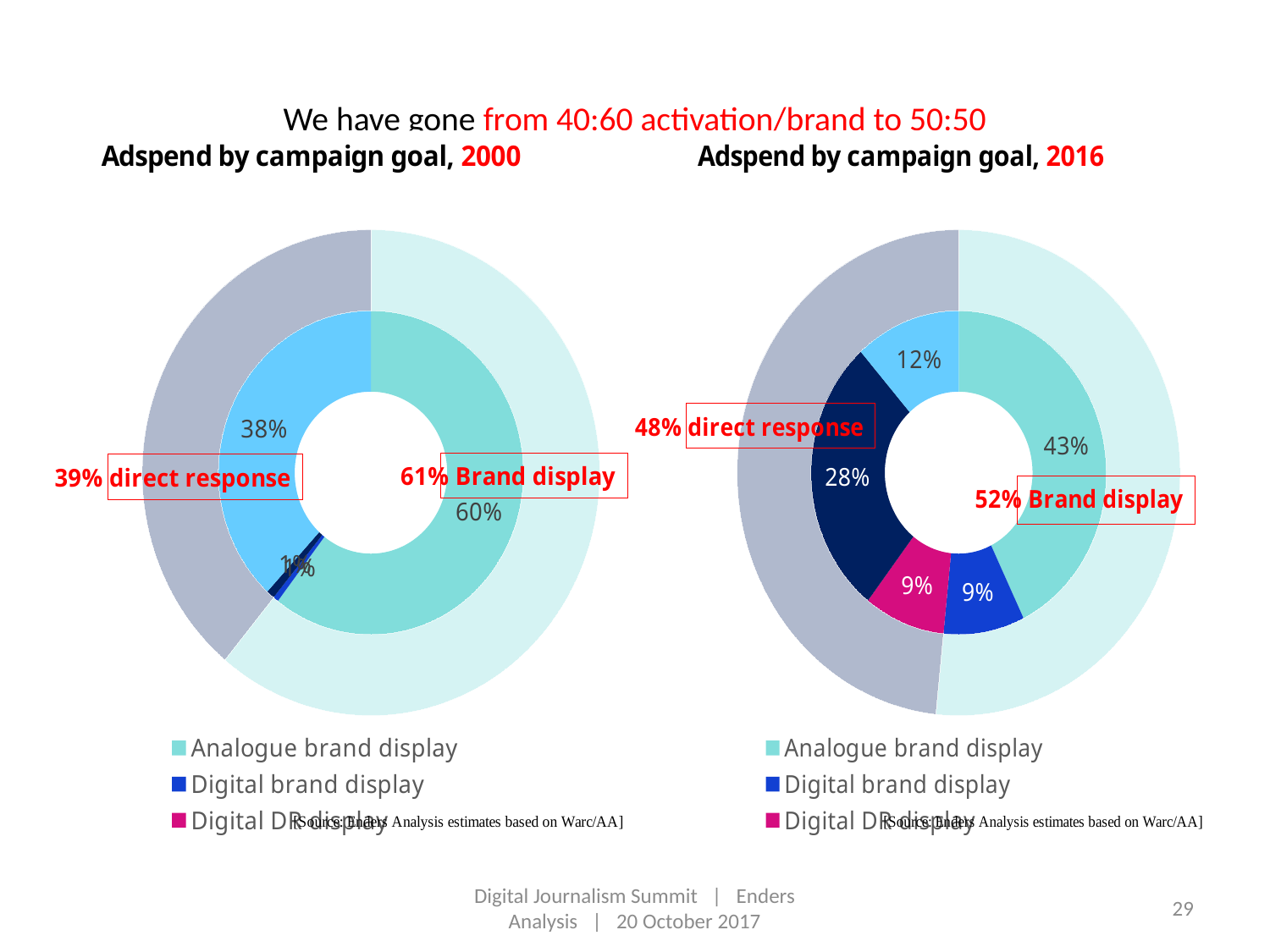
By how many percentage points is the Analogue brand display share in the 2000 chart larger than in the 2016 chart? 17 percentage points In the 'Adspend by campaign goal, 2016' chart, what share is labelled for Analogue brand display? 43% In the 'Adspend by campaign goal, 2000' chart, what share is labelled for Analogue brand display? 60% In the 'Adspend by campaign goal, 2000' chart, what share of adspend goes to direct response according to the outer ring label? 39% In the 'Adspend by campaign goal, 2016' chart, what share of adspend goes to Brand display according to the outer ring label? 52% In the 'Adspend by campaign goal, 2016' chart, what share is labelled for Digital brand display? 9% By how many percentage points did the Brand display share fall from the 2000 chart (61%) to the 2016 chart (52%)? 9 percentage points In the 'Adspend by campaign goal, 2016' chart, which is larger: Analogue brand display or Digital brand display? Analogue brand display What type of chart is used on this slide to show adspend by campaign goal? Doughnut chart In the 'Adspend by campaign goal, 2016' chart, which inner-ring segment is the largest? Analogue brand display (43%) In the 'Adspend by campaign goal, 2016' chart, what share of adspend goes to direct response according to the outer ring label? 48% In the 'Adspend by campaign goal, 2000' chart, what share of adspend goes to Brand display according to the outer ring label? 61%